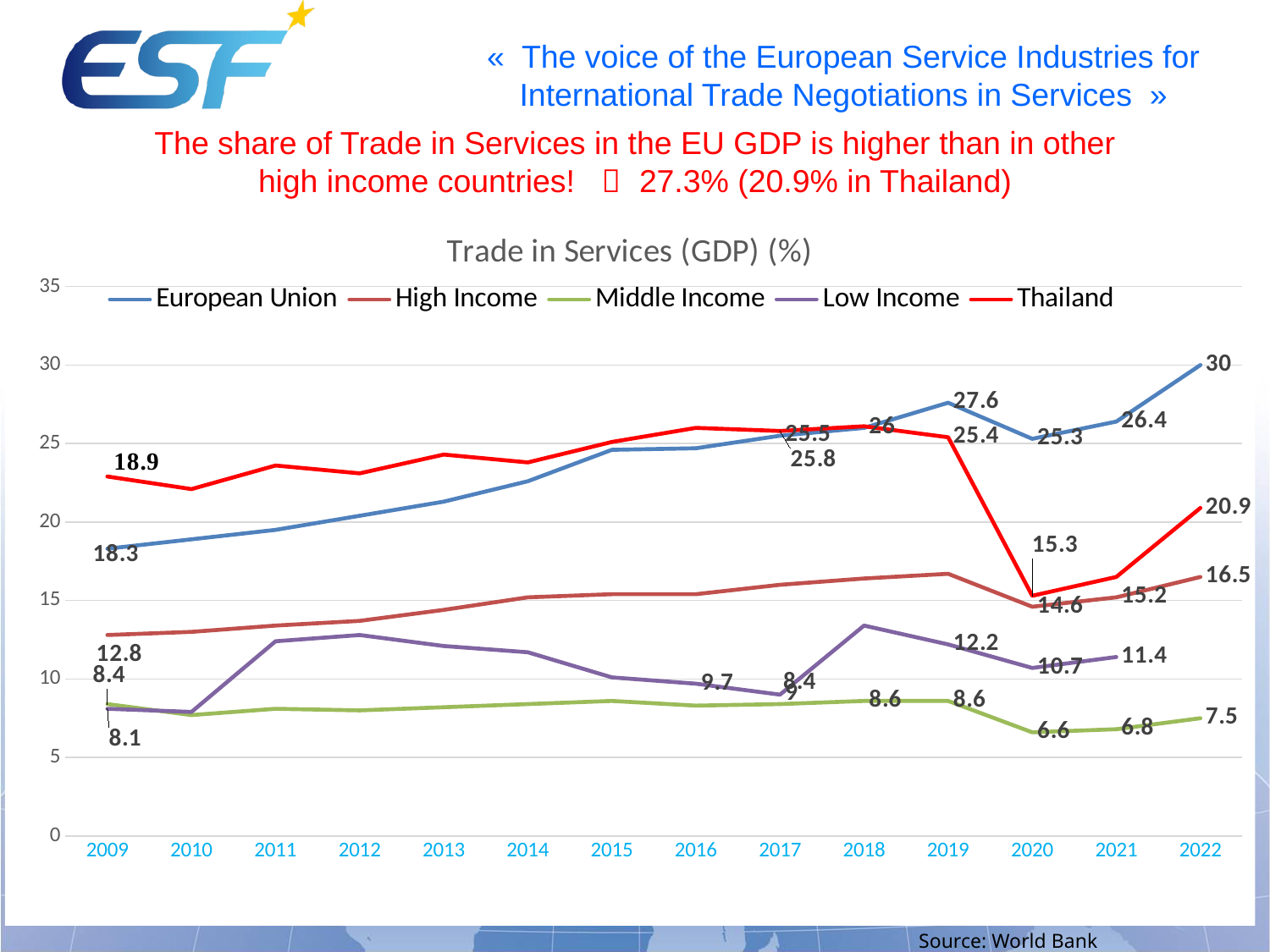
Which series has the lowest value in 2022? Middle Income What is the value for High Income in 2022? 16.5 Is the value for Low Income in 2012 greater or less than 10? greater What is the value for Thailand in 2020? 15.3 What is the value for the European Union in 2019? 27.6 What kind of chart is shown? Line chart Which is larger in 2020, the value for Thailand or the value for High Income? Thailand What is the difference between the European Union and Thailand values in 2022? 9.1 Which series has the highest value in 2022? European Union What is the value for Thailand in 2022? 20.9 How many series does the legend list? 5 What is the value for the European Union in 2022? 30